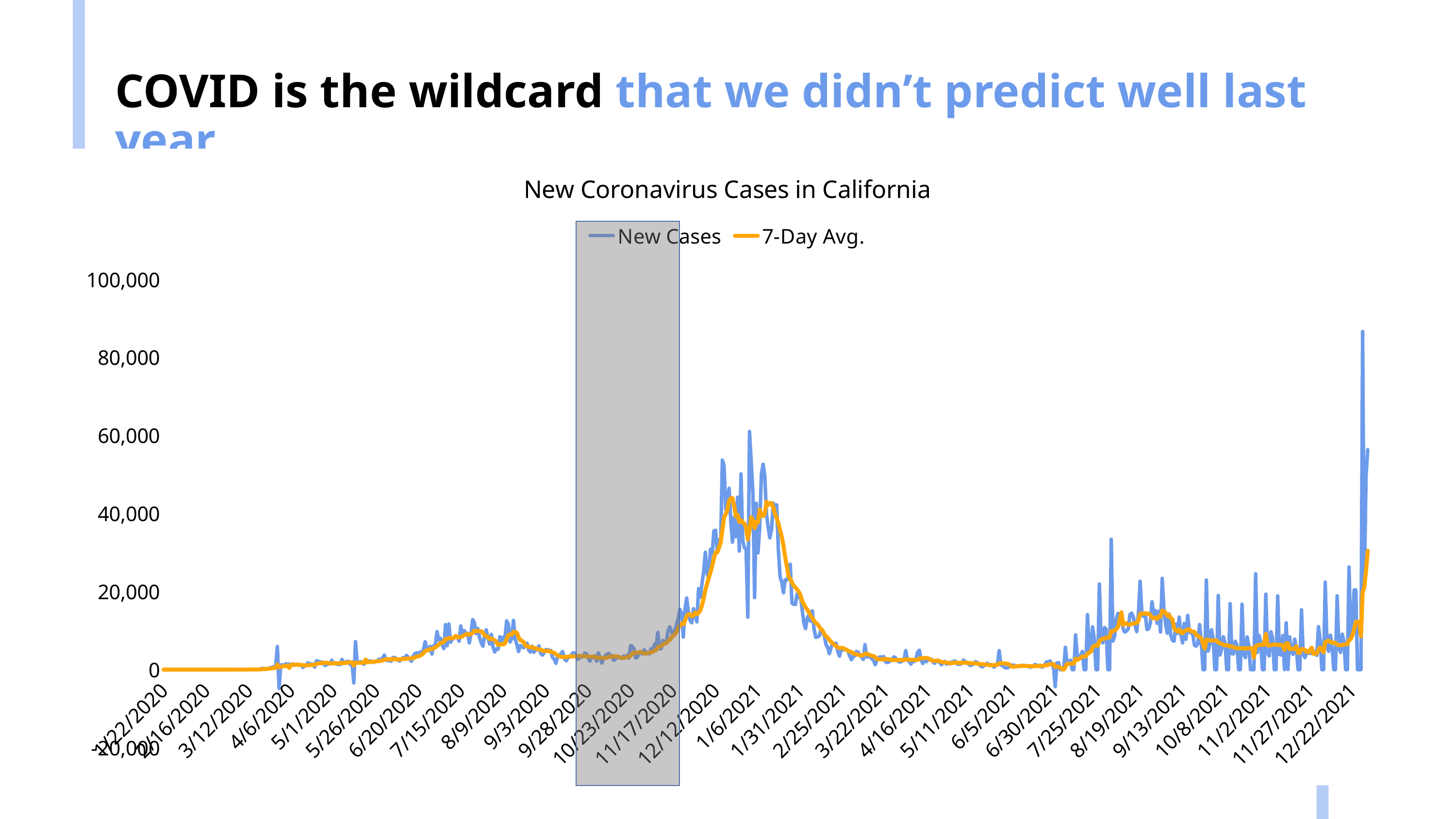
What colour is the 7-Day Avg. line in the chart? Orange What kind of chart is shown on the slide? Line chart What is the title of the chart? New Coronavirus Cases in California Is the 7-Day Avg. value around 8/19/2021 greater or less than 40,000? less How many series does the legend of the chart list? 2 Does the 7-Day Avg. series rise or fall between 6/30/2021 and 8/19/2021? Rise Is the 7-Day Avg. value around 5/11/2021 greater or less than 20,000? less Which series reaches the highest value on the chart, New Cases or 7-Day Avg.? New Cases Is the highest spike of the New Cases series, near the end of December 2021, greater or less than 80,000? greater Is the 7-Day Avg. peak around 1/6/2021 larger or smaller than its peak around 8/19/2021? Larger Does the 7-Day Avg. series rise or fall between 1/31/2021 and 4/16/2021? Fall